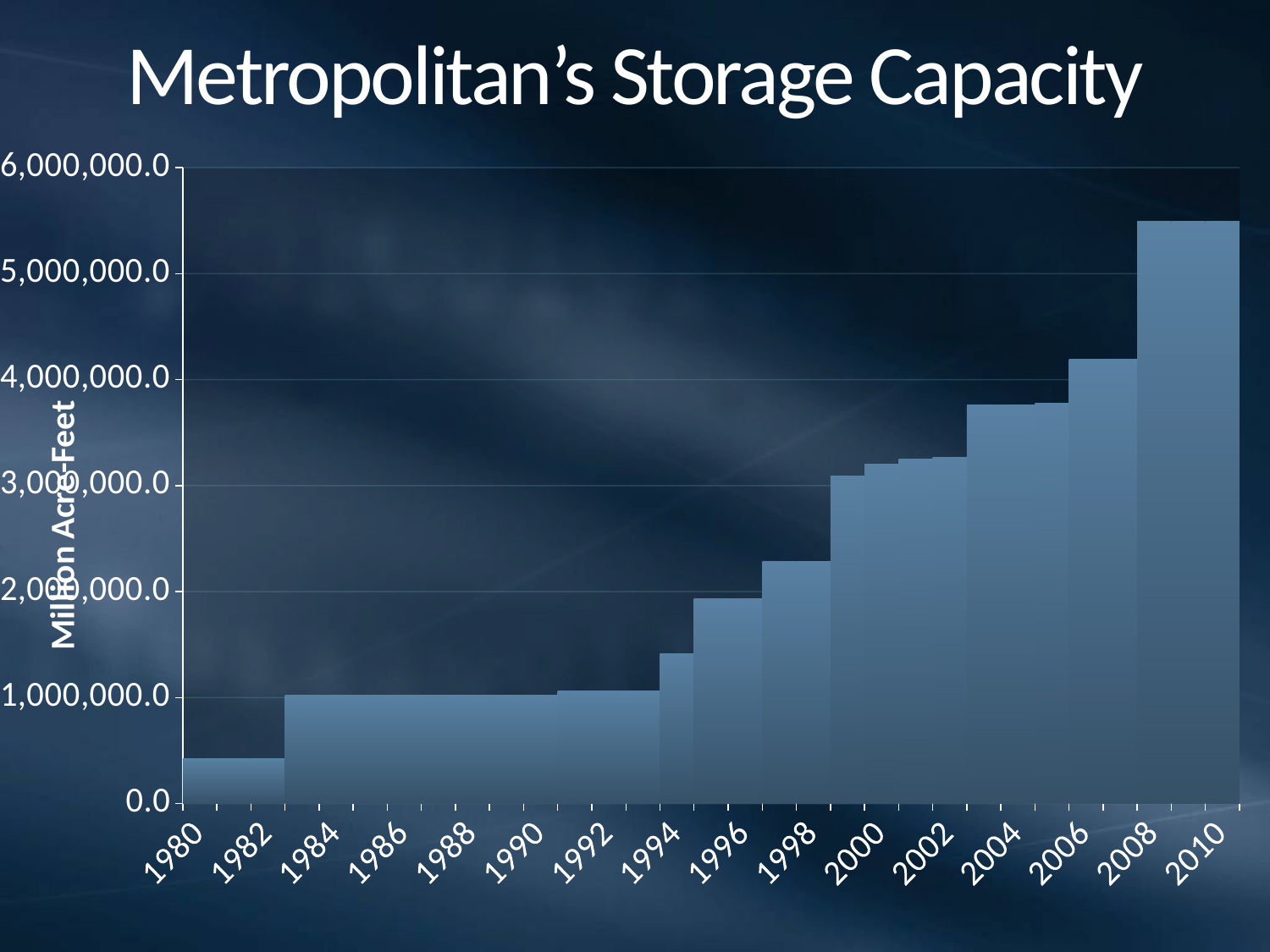
Is the value for 2010 greater or less than 5,000,000.0? greater Is the value for 2004 greater or less than 3,000,000.0? greater What is the title of the chart? Metropolitan's Storage Capacity Do the values generally rise or fall from 1980 to 2010? rise Is the value for 1980 greater or less than 1,000,000.0? less What type of chart is shown on the slide? bar chart Which is larger, the value for 1994 or the value for 2000? 2000 What is the label on the vertical axis? Million Acre-Feet How many year labels are shown on the x axis? 16